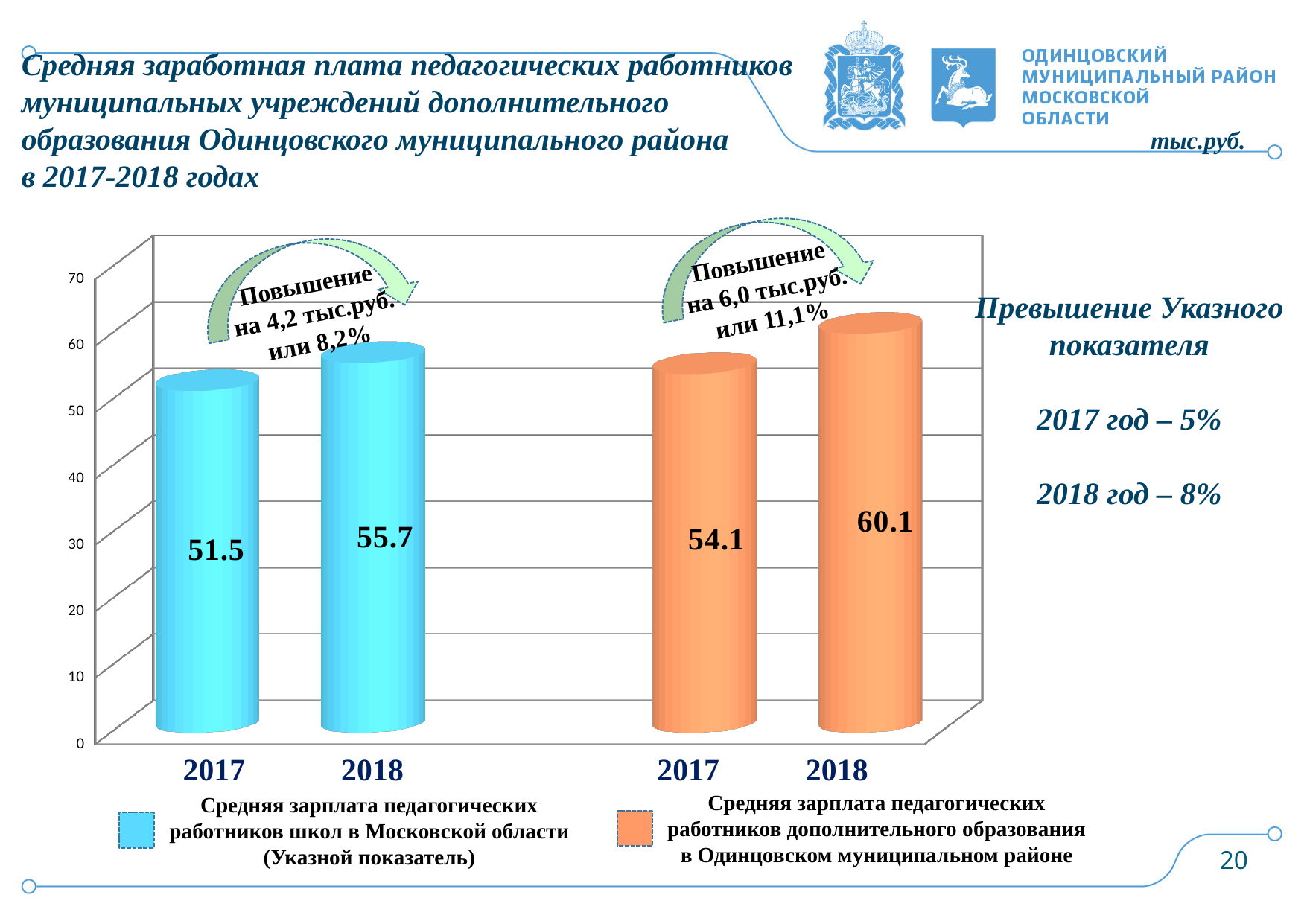
By how much did the average salary of supplementary education teaching staff in Odintsovo district increase from 2017 to 2018? 6.0 What is the average salary of teaching staff in Moscow region schools (Указной показатель) in 2018? 55.7 Which bar shows the lowest value on the chart? 2017, Moscow region schools (Указной показатель) (51.5) What is the average salary of teaching staff in Moscow region schools (Указной показатель) in 2017? 51.5 Which bar shows the highest value on the chart? 2018, supplementary education in Odintsovo municipal district (60.1) What kind of chart is shown on the slide? Bar chart What is the average salary of teaching staff in supplementary education in Odintsovo municipal district in 2018? 60.1 Do the values for each series rise or fall from 2017 to 2018? Rise What is the difference between the Odintsovo supplementary education salary and the Moscow region school salary in 2018? 4.4 What is the average salary of teaching staff in supplementary education in Odintsovo municipal district in 2017? 54.1 How many series does the legend list? 2 Which is larger in 2017: the Moscow region school salary or the Odintsovo supplementary education salary? Odintsovo supplementary education salary (54.1)